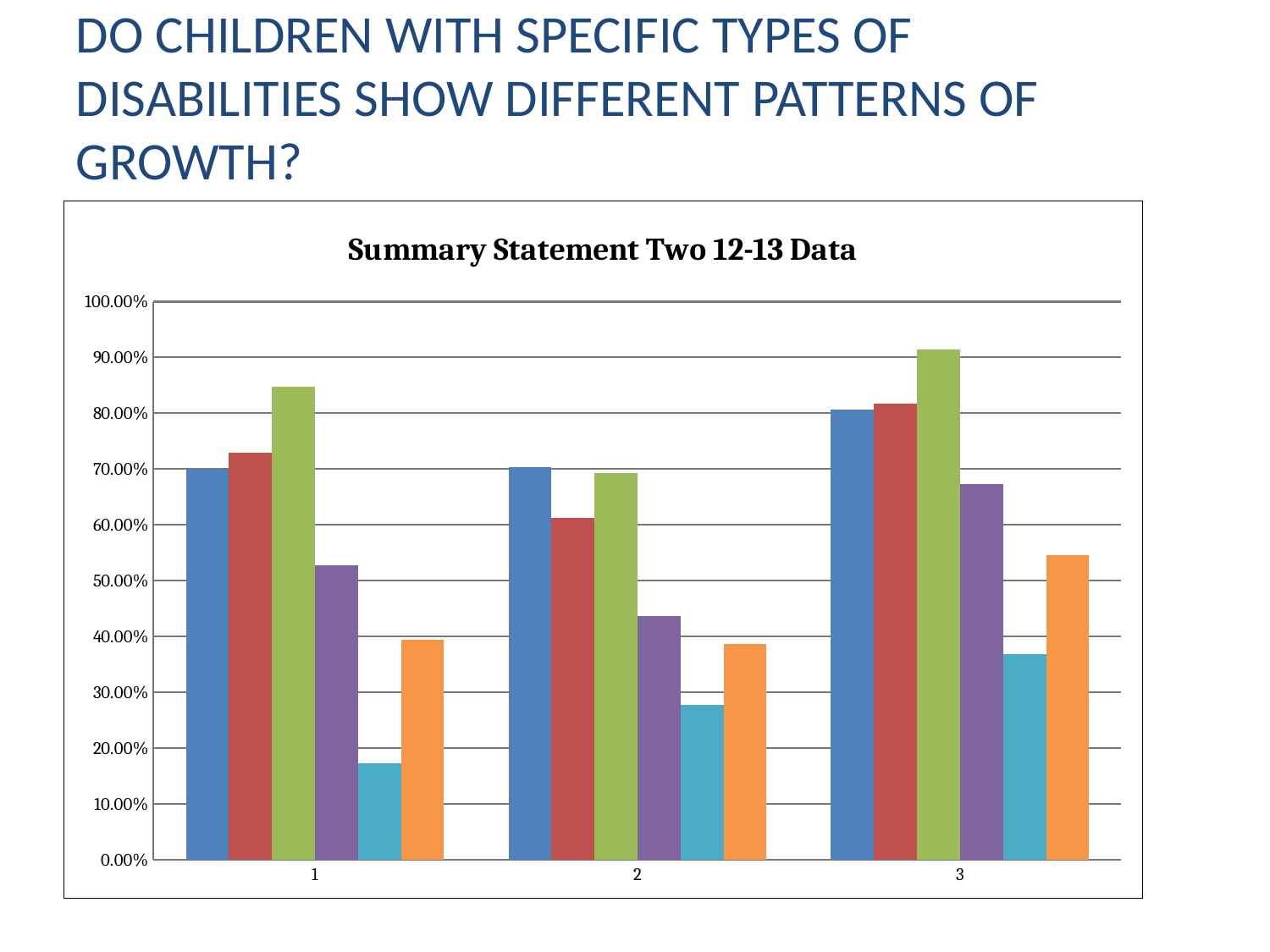
How many categories are shown on the x axis? 3 Which bar is the shortest in category 1? the teal bar Which bar is the tallest in category 3? the green bar What is the title of the chart? Summary Statement Two 12-13 Data How many bars are plotted for each category? 6 Is the value of the purple bar in category 2 greater or less than 50.00%? less In category 2, which is larger, the red bar or the green bar? the green bar Does the teal bar's value rise or fall from category 1 to category 3? rise Is the value of the teal bar in category 1 greater or less than 20.00%? less Is the value of the green bar in category 3 greater or less than 90.00%? greater What kind of chart is shown on the slide? bar chart